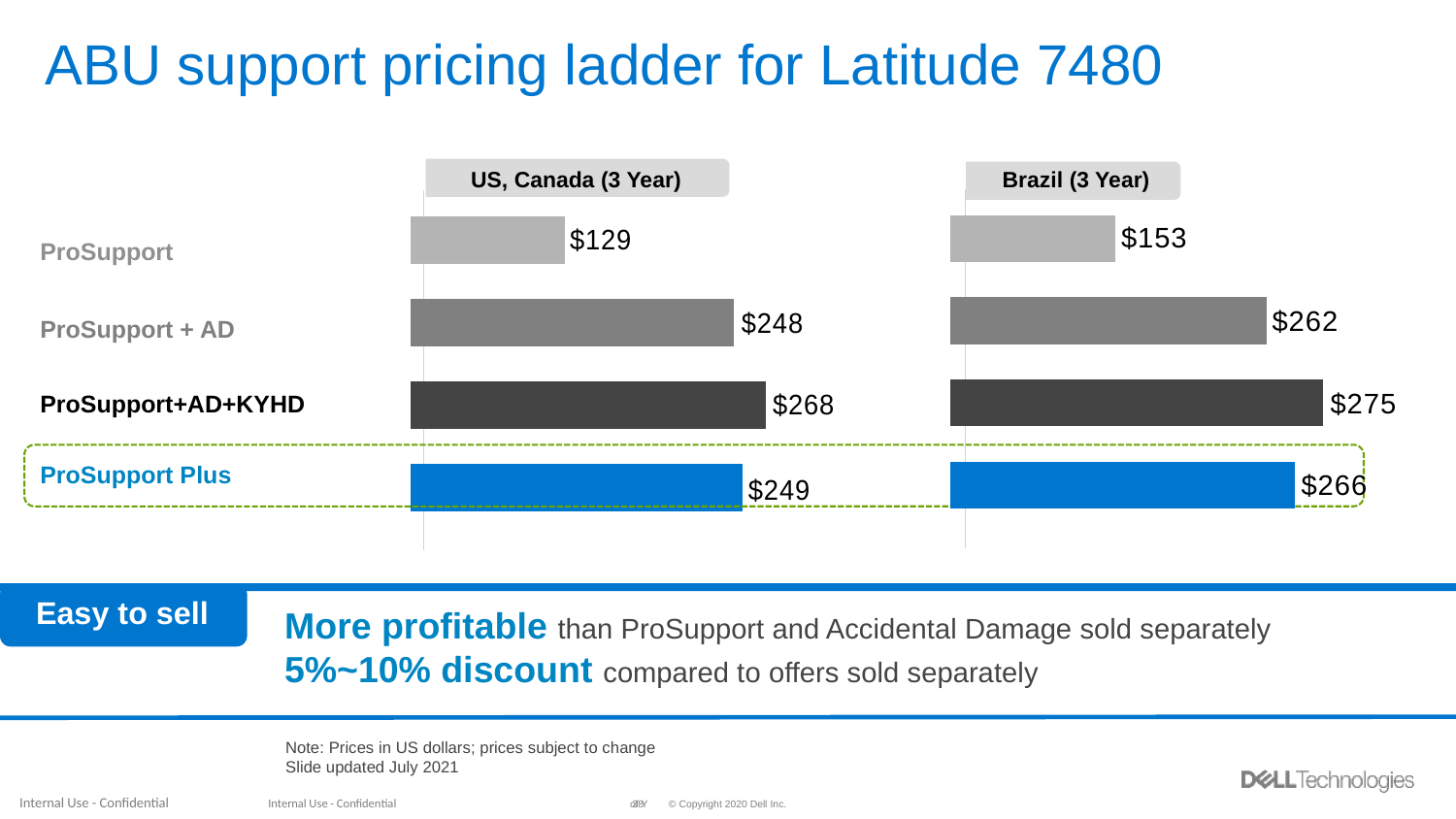
In the Brazil (3 Year) chart, which support option has the lowest price? ProSupport In the US, Canada (3 Year) chart, what is the difference between the ProSupport Plus price and the ProSupport + AD price? $1 In the US, Canada (3 Year) chart, which support option has the highest price? ProSupport+AD+KYHD In the Brazil (3 Year) chart, what is the price for ProSupport Plus? $266 What kind of chart is used to show the Brazil (3 Year) prices? Bar chart Is the ProSupport Plus price higher in the US, Canada (3 Year) chart or in the Brazil (3 Year) chart? Brazil (3 Year) How many support options are shown in the US, Canada (3 Year) chart? 4 In the US, Canada (3 Year) chart, what is the price for ProSupport+AD+KYHD? $268 In the Brazil (3 Year) chart, what is the price for ProSupport + AD? $262 In the US, Canada (3 Year) chart, which support option's bar is coloured blue? ProSupport Plus In the US, Canada (3 Year) chart, what is the price for ProSupport? $129 In the Brazil (3 Year) chart, what is the difference between the ProSupport+AD+KYHD price and the ProSupport price? $122